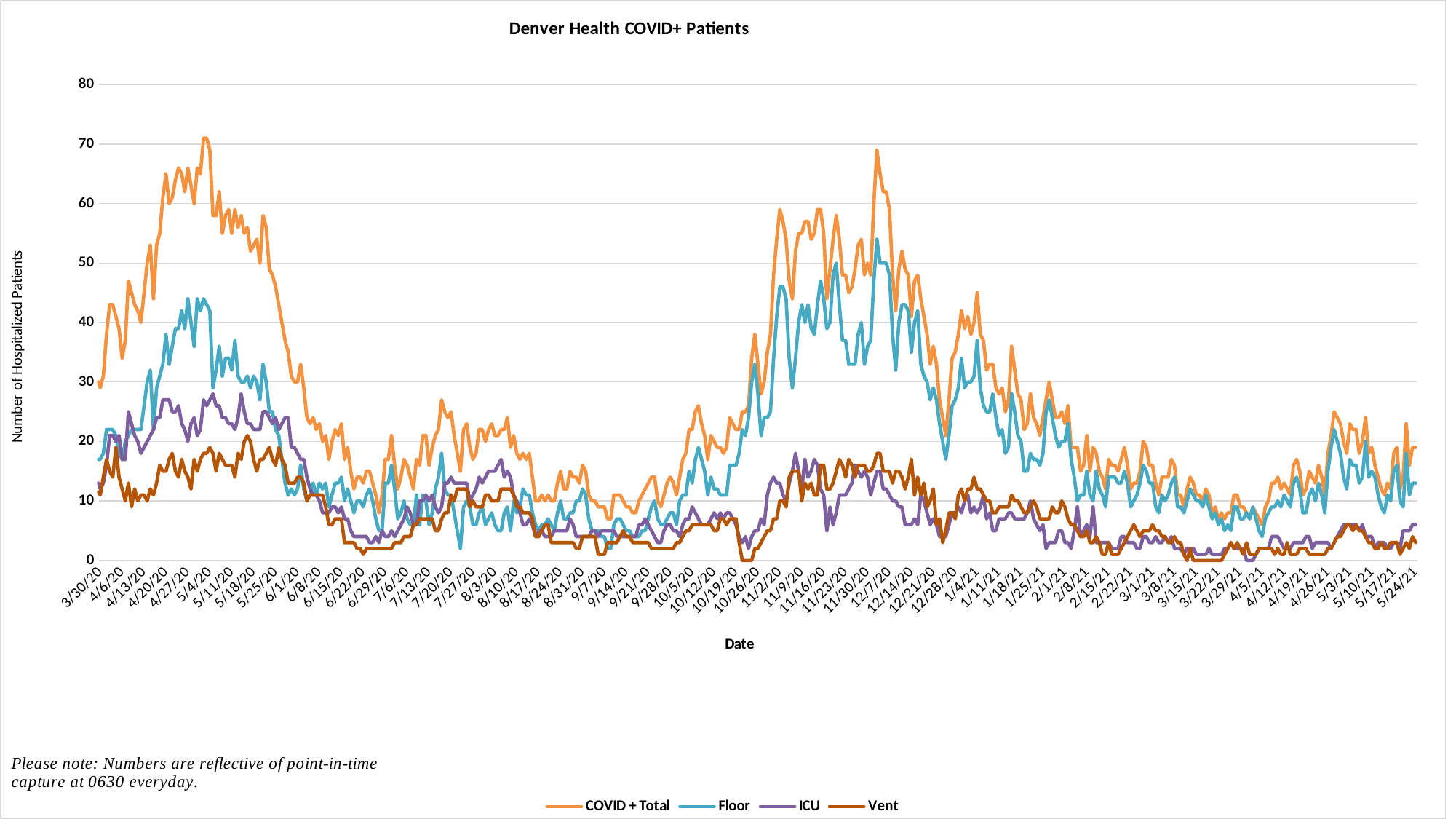
What is the title of the chart? Denver Health COVID+ Patients Does the COVID + Total series rise or fall between 10/5/20 and 11/9/20? rise Is the value of the Vent series around 6/22/20 greater or less than 10? less Around 4/27/20, which is larger: the COVID + Total series or the Floor series? COVID + Total Which series reaches the highest peak on the chart? COVID + Total Is the peak value of the COVID + Total series in spring 2020 greater or less than 60? greater What kind of chart is shown on the slide? line chart What is the label of the vertical axis? Number of Hospitalized Patients Does the COVID + Total series rise or fall between 5/4/20 and 6/22/20? fall How many series does the legend list? 4 Is the value of the COVID + Total series around 7/6/20 greater or less than 20? less